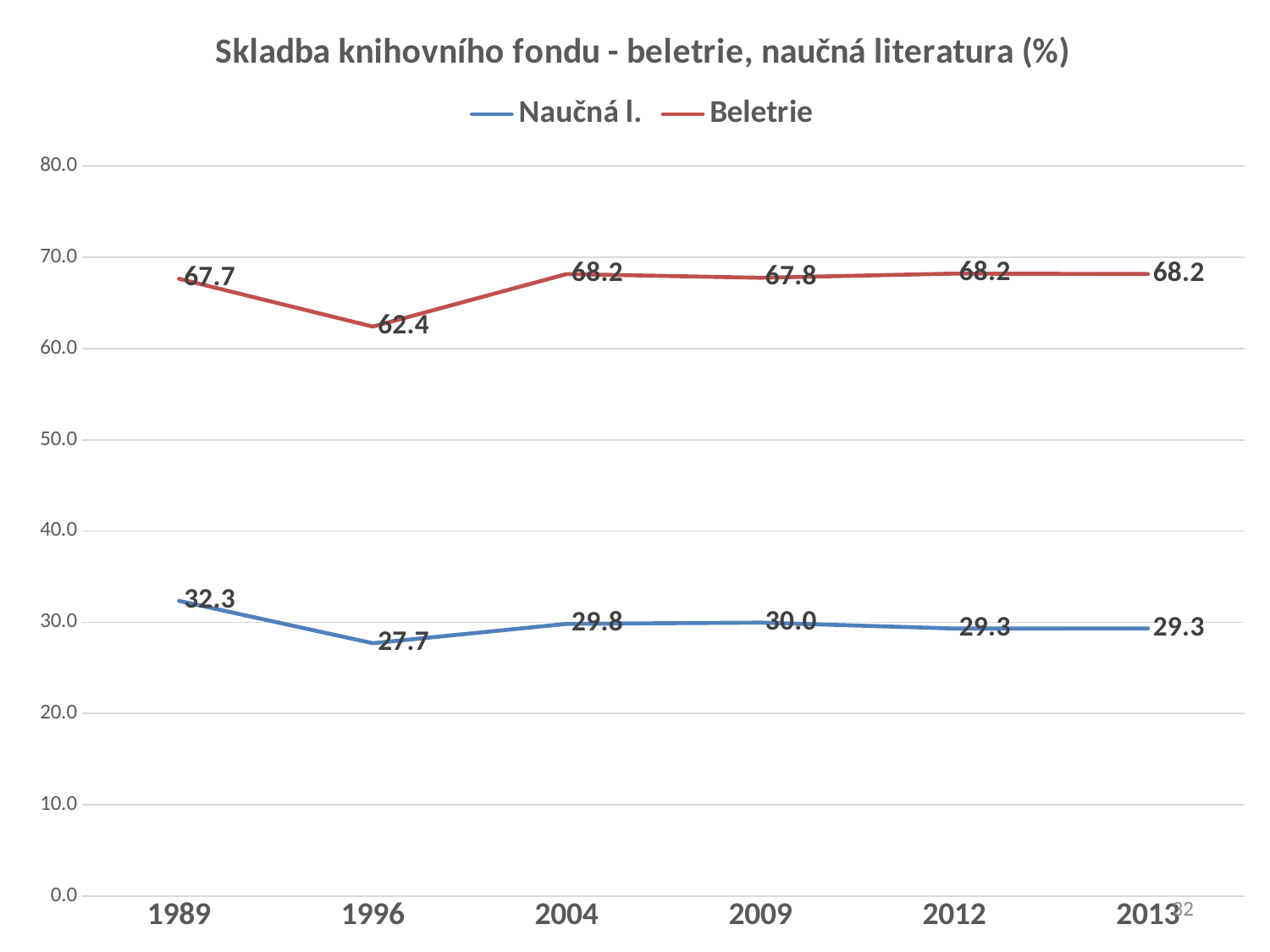
How many series does the legend list? 2 Which series has the larger value in 2004, Naučná l. or Beletrie? Beletrie What is the value for Naučná l. in 2009? 30.0 In which year is the Naučná l. value highest? 1989 What is the title of the chart? Skladba knihovního fondu - beletrie, naučná literatura (%) What is the difference between the Beletrie and Naučná l. values in 2013? 38.9 In which year is the Beletrie value lowest? 1996 What kind of chart is shown on the slide? Line chart What is the value for Naučná l. in 1989? 32.3 Does the Naučná l. value rise or fall from 1989 to 1996? Fall What is the value for Beletrie in 1996? 62.4 How many years are shown on the x axis? 6